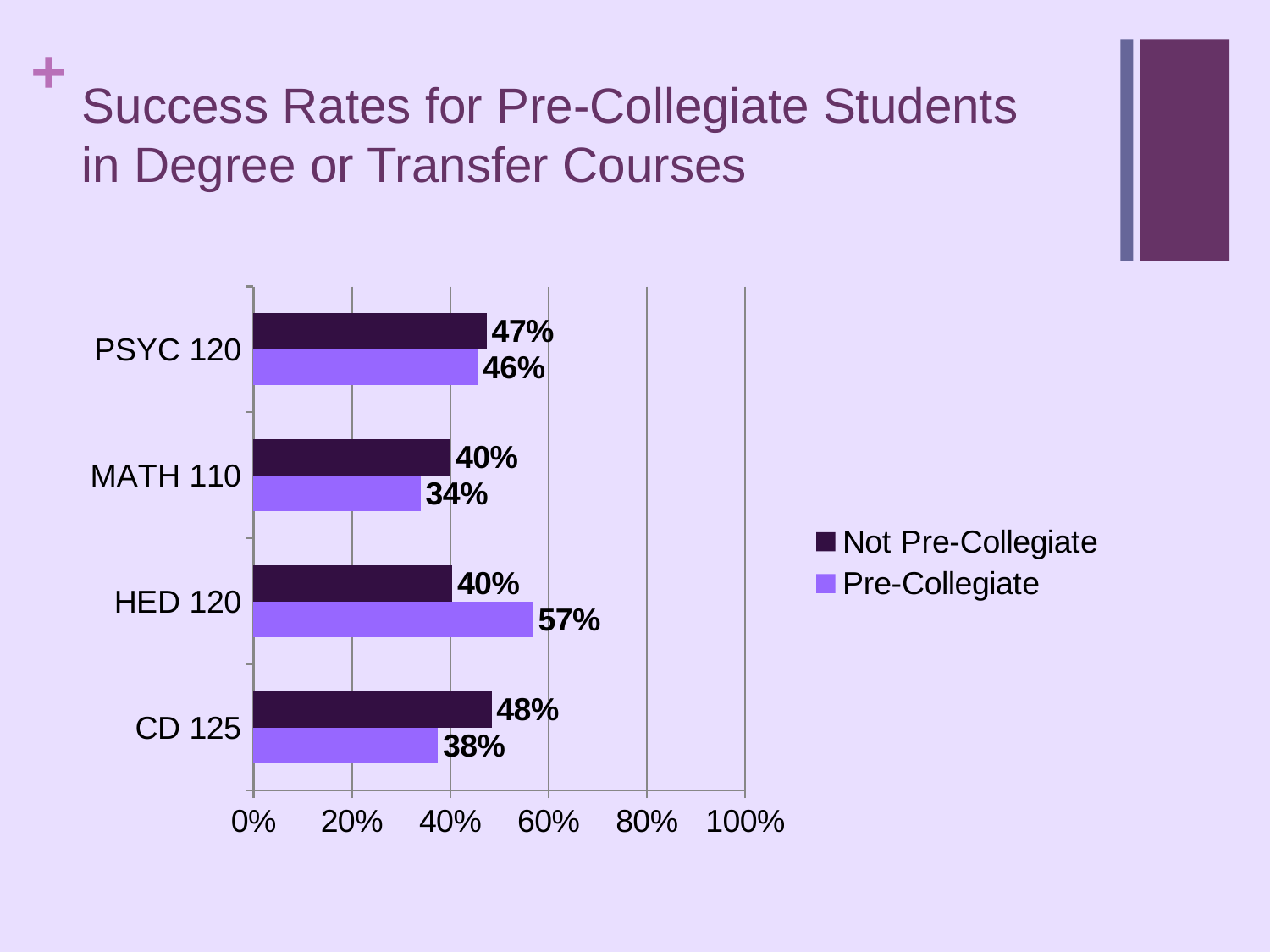
Which course has the highest Not Pre-Collegiate success rate? CD 125 Which course has the lowest Pre-Collegiate success rate? MATH 110 What is the Pre-Collegiate success rate for HED 120? 57% What is the difference between the Not Pre-Collegiate and Pre-Collegiate success rates for CD 125? 10% What is the difference between the Pre-Collegiate and Not Pre-Collegiate success rates for HED 120? 17% What is the Pre-Collegiate success rate for CD 125? 38% What kind of chart is shown on the slide? Bar chart What is the Not Pre-Collegiate success rate for MATH 110? 40% How many series does the legend list? 2 For MATH 110, which is larger: the Not Pre-Collegiate or the Pre-Collegiate success rate? Not Pre-Collegiate How many courses are shown in the chart? 4 Which course has the highest Pre-Collegiate success rate? HED 120